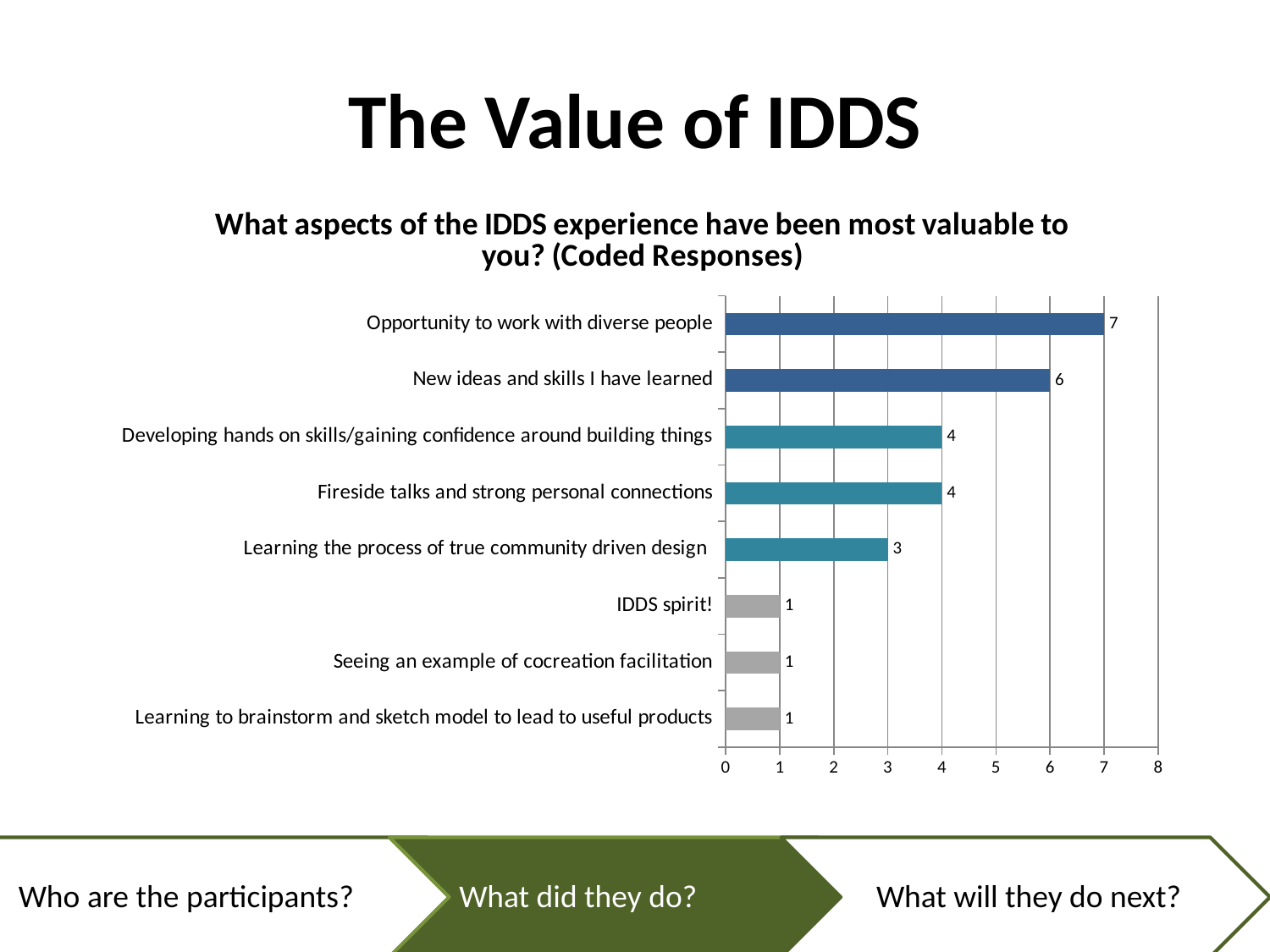
What is the value for "Opportunity to work with diverse people"? 7 What is the value for "Learning the process of true community driven design"? 3 What is the value for "New ideas and skills I have learned"? 6 What is the difference between the values for "Developing hands on skills/gaining confidence around building things" and "Learning the process of true community driven design"? 1 What is the difference between the values for "Opportunity to work with diverse people" and "New ideas and skills I have learned"? 1 What is the value for "IDDS spirit!"? 1 Which is larger, the value for "Fireside talks and strong personal connections" or the value for "Seeing an example of cocreation facilitation"? Fireside talks and strong personal connections How many categories are shown in the chart? 8 Which category has the highest value? Opportunity to work with diverse people What is the title of the chart? What aspects of the IDDS experience have been most valuable to you? (Coded Responses) What kind of chart is shown on the slide? bar chart Is the value for "New ideas and skills I have learned" greater or less than 5? greater